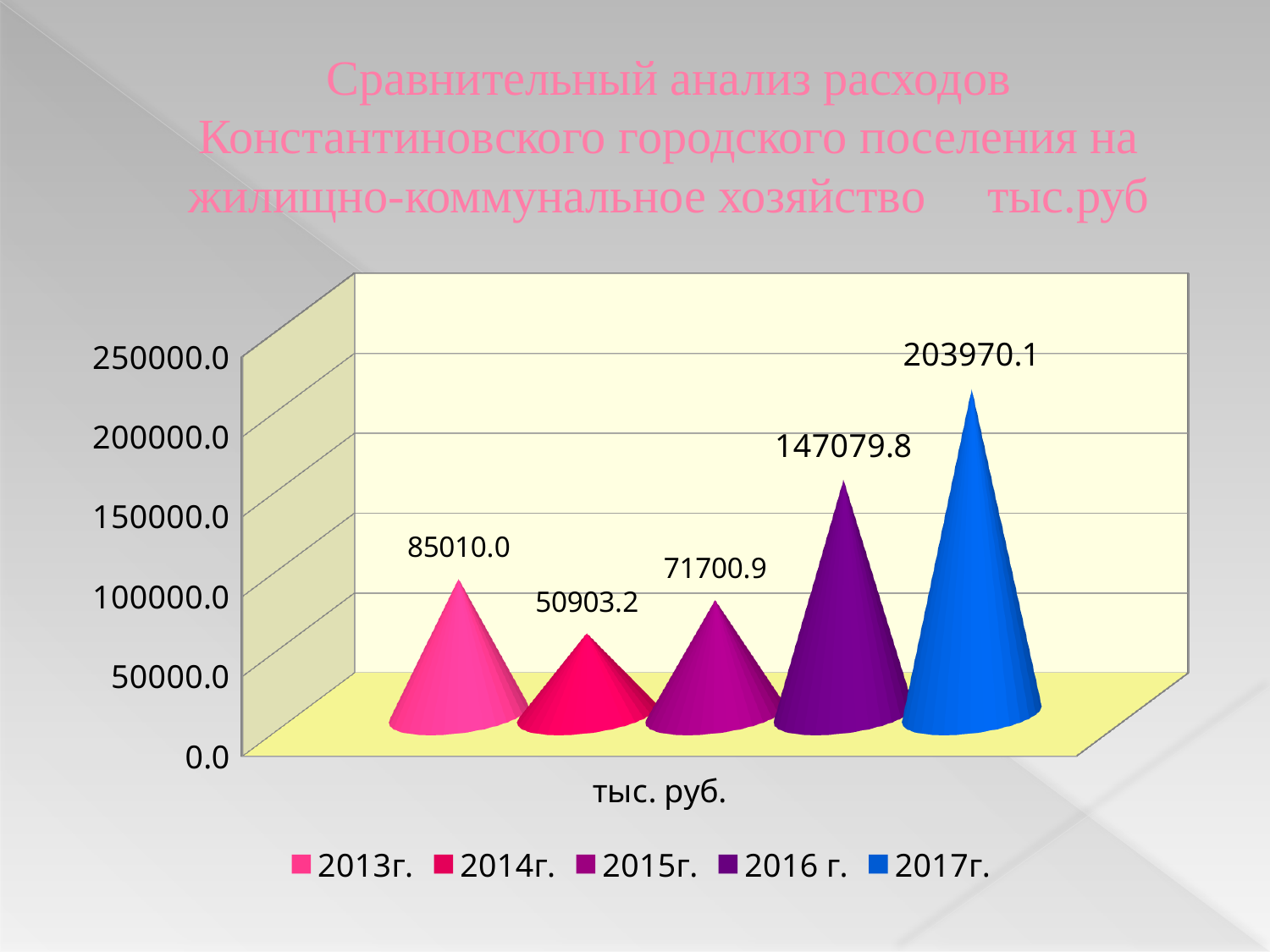
Which year has the highest value? 2017г. What is the value for 2015г.? 71700.9 How many series does the legend list? 5 What is the value for 2017г.? 203970.1 Is the value for 2016 г. greater or less than 100000.0? greater What is the value for 2014г.? 50903.2 Which is larger, the value for 2013г. or the value for 2015г.? 2013г. Do the values rise or fall from 2014г. through 2017г.? rise What colour is the 2017г. series in the legend? blue What is the difference between the values for 2017г. and 2016 г.? 56890.3 What is the difference between the values for 2013г. and 2014г.? 34106.8 Which year has the lowest value? 2014г.